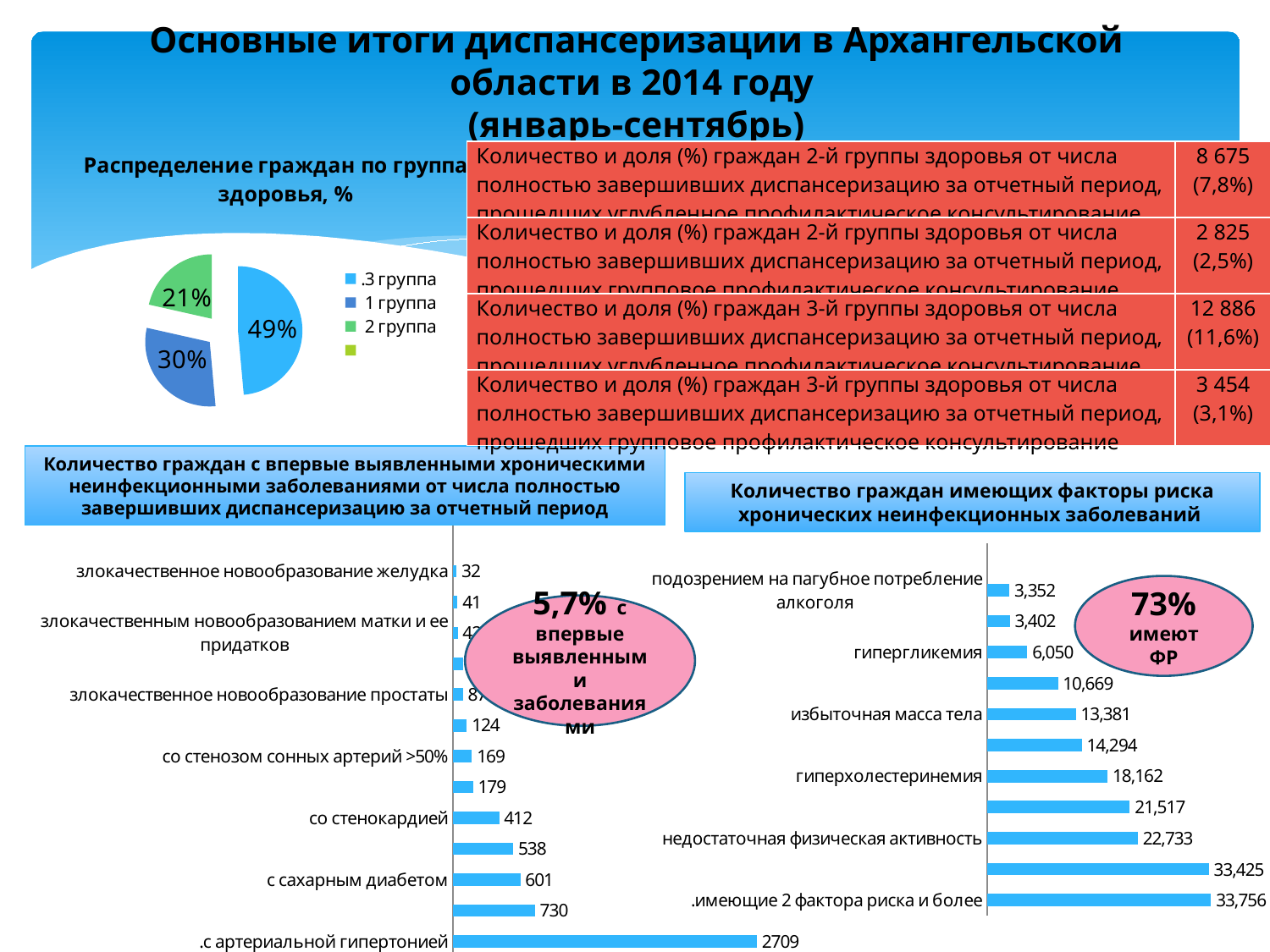
In the bottom-right chart on risk factors, what is the difference between 'имеющие 2 фактора риска и более' and 'недостаточная физическая активность'? 11,023 In the pie chart 'Распределение граждан по группам здоровья, %', what share does '3 группа' have? 49% What type of chart is 'Распределение граждан по группам здоровья, %'? pie chart In the bottom-right chart on risk factors, what is the value for 'гиперхолестеринемия'? 18,162 In the bottom-left chart on newly detected chronic diseases, what is the value for 'с артериальной гипертонией'? 2709 In the pie chart 'Распределение граждан по группам здоровья, %', which group has the smallest share? 2 группа In the bottom-left chart on newly detected chronic diseases, what is the difference between 'с артериальной гипертонией' and 'с сахарным диабетом'? 2108 In the bottom-left chart on newly detected chronic diseases, which category has the highest value? с артериальной гипертонией In the bottom-right chart on risk factors, which is larger: 'избыточная масса тела' or 'гипергликемия'? избыточная масса тела In the bottom-left chart on newly detected chronic diseases, what is the value for 'со стенокардией'? 412 In the bottom-right chart on risk factors, which category has the lowest value? подозрением на пагубное потребление алкоголя In the pie chart 'Распределение граждан по группам здоровья, %', what share does '1 группа' have? 30%